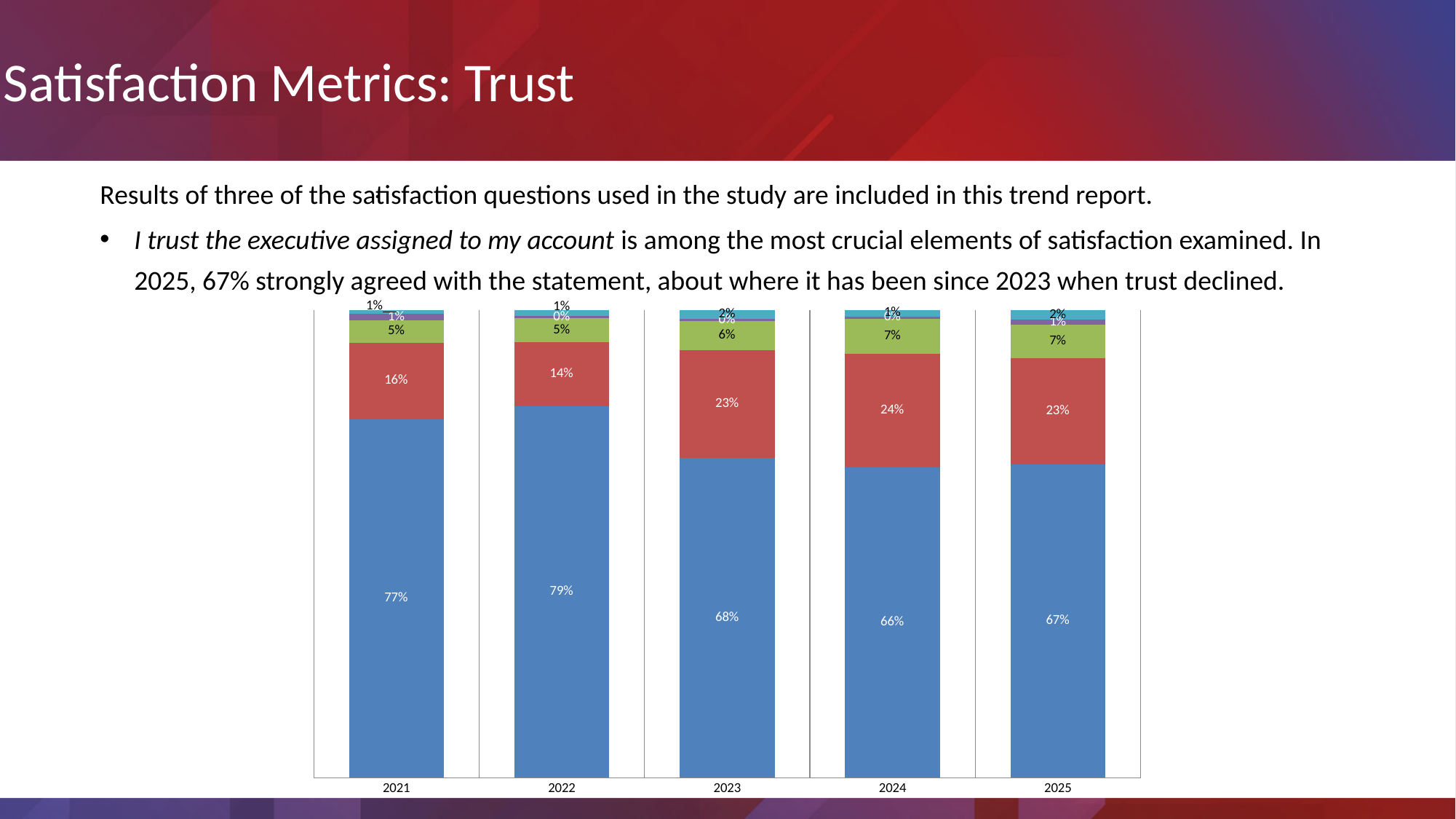
Does the blue (bottom) segment rise or fall from 2022 to 2024? Fall In which year is the blue (bottom) segment the largest? 2022 What is the total of the stacked bar for 2021? 100% What kind of chart is shown on the slide? Stacked bar chart What is the value of the blue (bottom) segment for 2025? 67% What is the value of the green segment for 2024? 7% How many coloured segments make up each stacked bar? 5 Which year has the larger red segment, 2021 or 2023? 2023 By how many percentage points did the blue (bottom) segment change from 2022 to 2023? 11 percentage points How many years are shown on the x axis? 5 In which year is the blue (bottom) segment the smallest? 2024 What is the value of the red segment for 2022? 14%